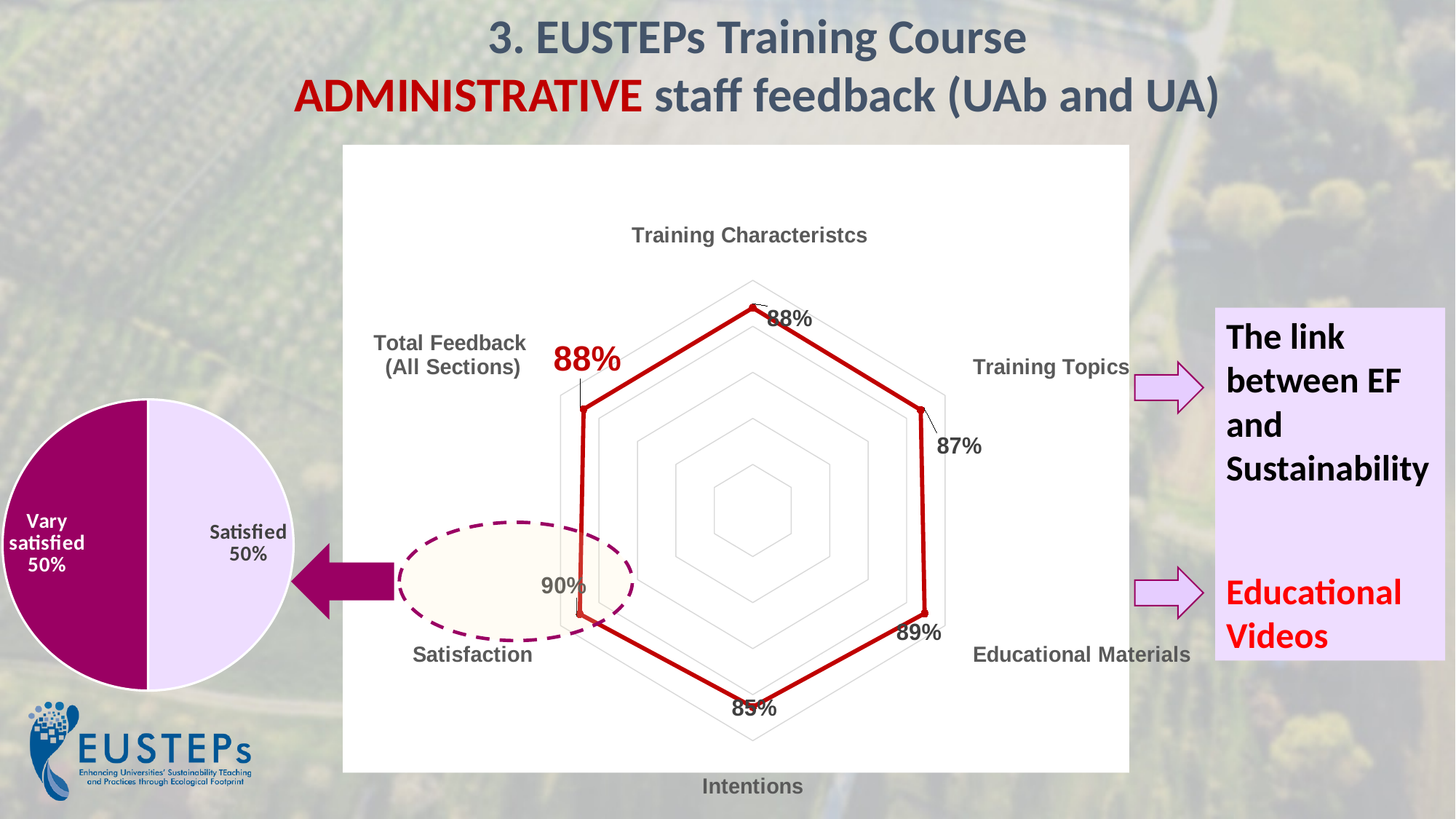
What kind of chart is the large chart in the centre of the slide? Radar chart How many slices does the pie chart on the left have? 2 On the pie chart on the left, what share is labelled Satisfied? 50% On the radar chart, what is the value for Training Topics? 87% On the radar chart, what is the value for Total Feedback (All Sections)? 88% On the radar chart, what is the value for Intentions? 85% On the radar chart, which is larger: the value for Educational Materials or the value for Training Topics? Educational Materials On the radar chart, what is the value for Educational Materials? 89% On the radar chart, which category has the highest value? Satisfaction On the radar chart, what is the difference between the Satisfaction value and the Intentions value? 5% How many categories does the radar chart have? 6 On the radar chart, which category has the lowest value? Intentions